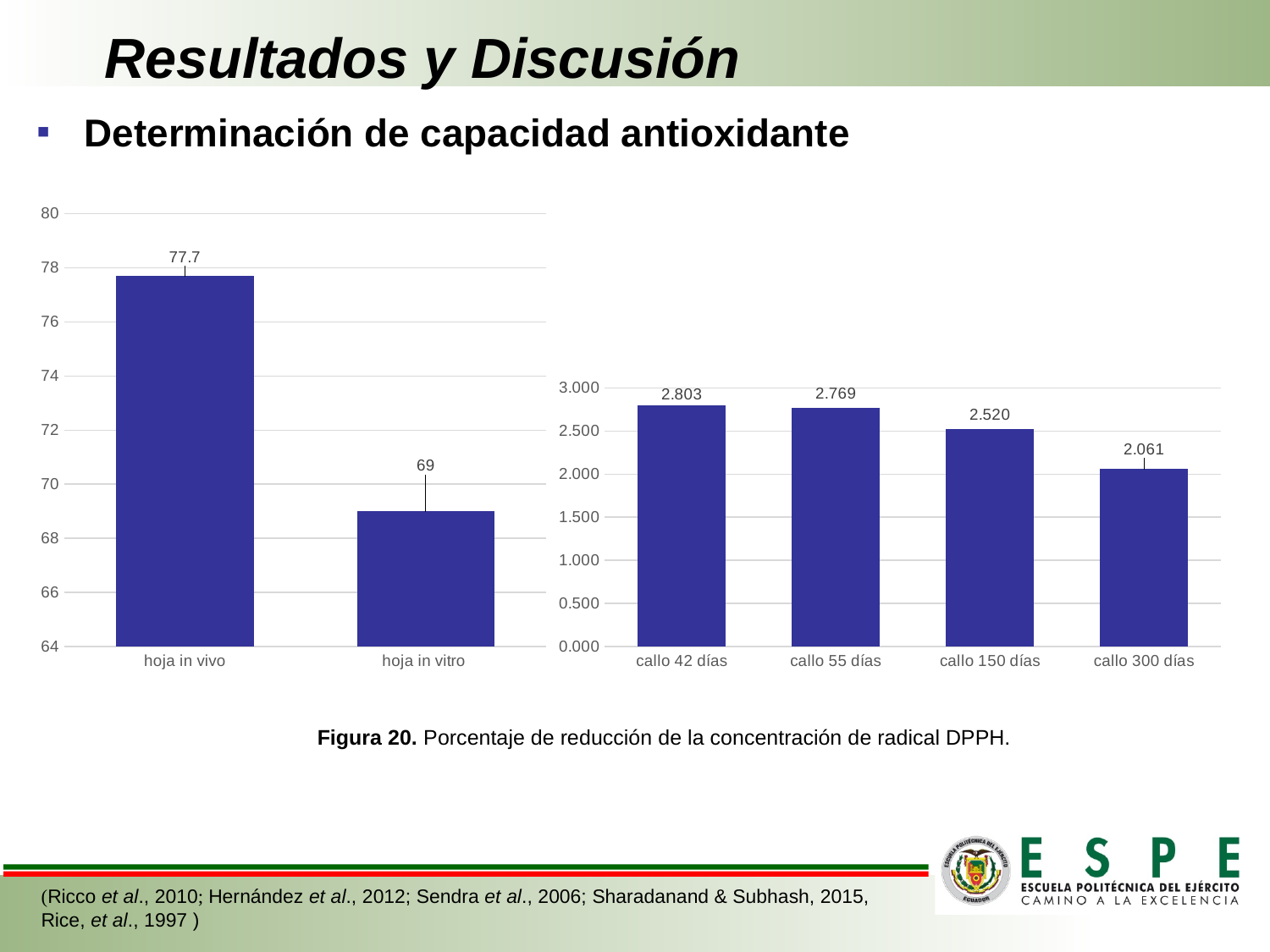
What kind of chart is the right chart? bar chart In the right chart, what is the value for callo 300 días? 2.061 In the left chart, what is the value for hoja in vivo? 77.7 In the left chart, how many categories are shown? 2 In the left chart, what is the difference between the values for hoja in vivo and hoja in vitro? 8.7 In the left chart, what is the value for hoja in vitro? 69 In the left chart, which category has the higher value, hoja in vivo or hoja in vitro? hoja in vivo In the right chart, which category has the highest value? callo 42 días In the right chart, what is the value for callo 42 días? 2.803 In the right chart, how many categories are shown? 4 In the right chart, do the values rise or fall from callo 42 días to callo 300 días? fall In the right chart, which category has the lowest value? callo 300 días